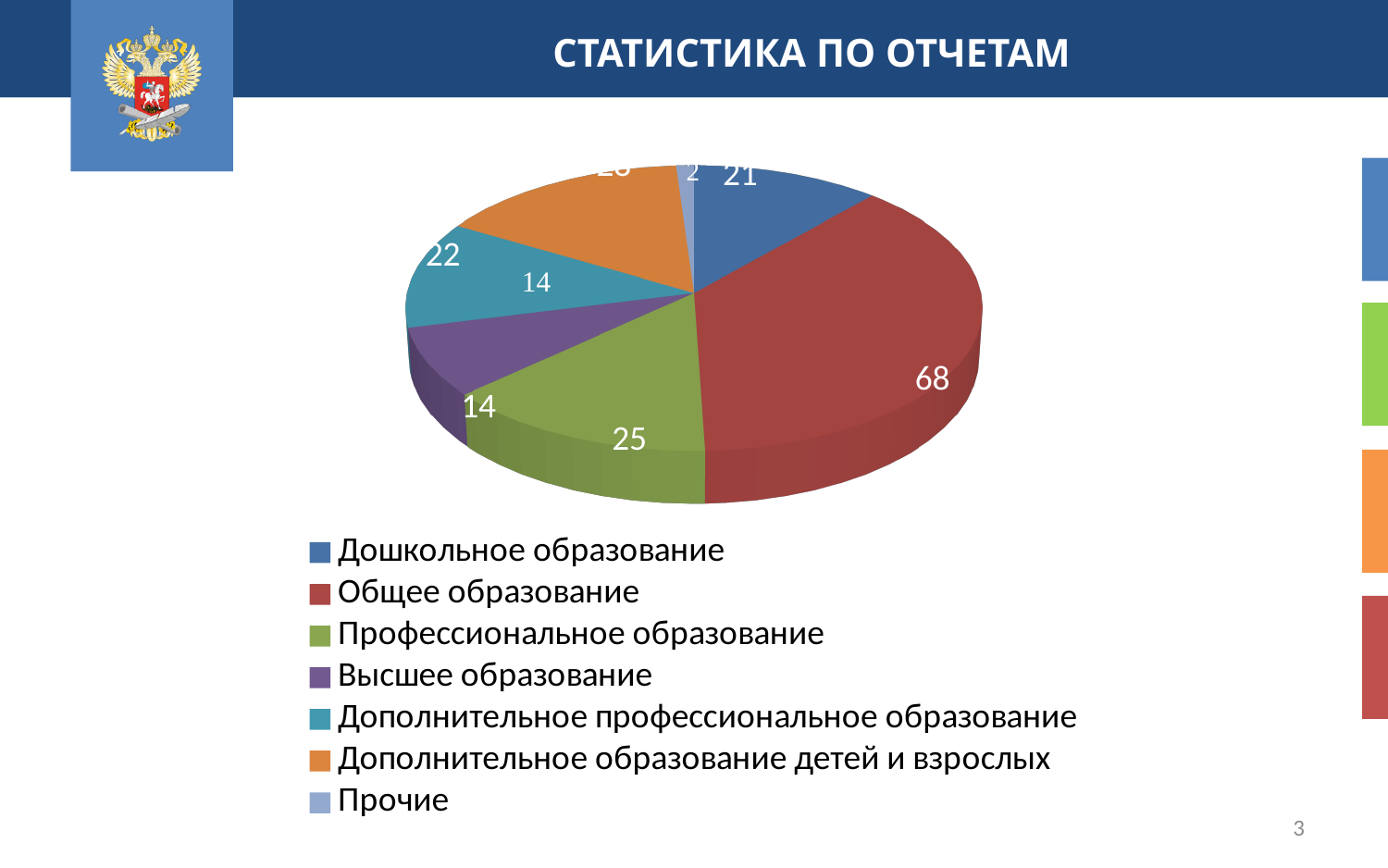
What is the value for Общее образование in the pie chart? 68 Which category has the smallest slice in the pie chart? Прочие Which category has the largest slice in the pie chart? Общее образование What is the value for Дошкольное образование in the pie chart? 21 What colour is the slice for Общее образование in the pie chart? red What is the difference between the values for Общее образование and Профессиональное образование? 43 How many categories does the legend of the pie chart list? 7 Which is larger in the pie chart: Общее образование or Профессиональное образование? Общее образование What is the title of the slide with the pie chart? СТАТИСТИКА ПО ОТЧЕТАМ What is the value for Прочие in the pie chart? 2 What is the value for Профессиональное образование in the pie chart? 25 What kind of chart is shown on the slide? pie chart